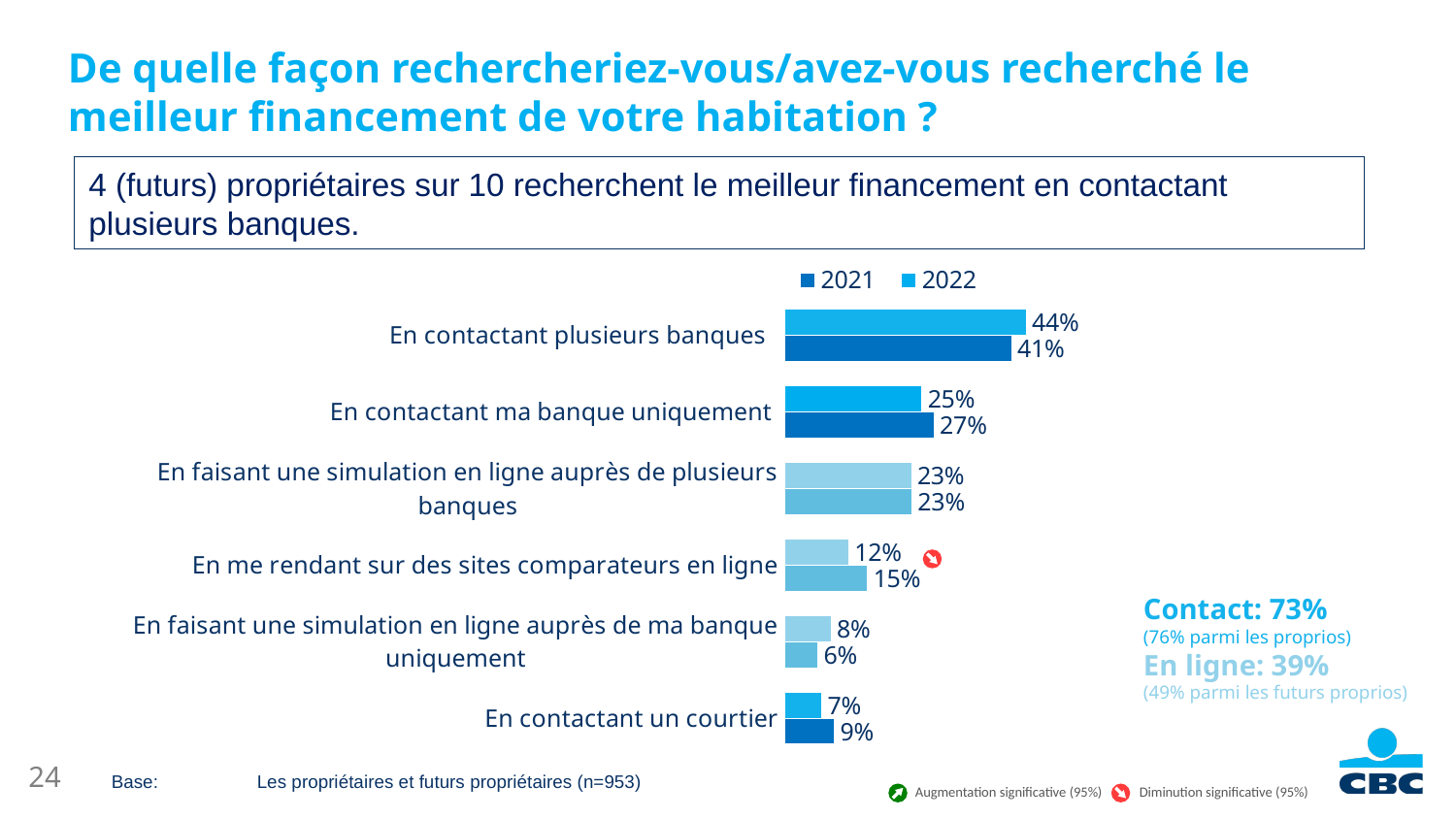
How many series does the chart legend list? 2 What is the 2021 value for 'En contactant ma banque uniquement'? 27% What is the difference between the 2022 and 2021 values for 'En contactant plusieurs banques'? 3% What is the 2021 value for 'En contactant plusieurs banques'? 41% Which category has the highest 2022 value? En contactant plusieurs banques What is the 2022 value for 'En me rendant sur des sites comparateurs en ligne'? 12% What kind of chart is shown on the slide? bar chart For 'En contactant ma banque uniquement', which year has the larger value, 2021 or 2022? 2021 What is the 2022 value for 'En contactant plusieurs banques'? 44% How many categories are shown in the chart? 6 Which category has the lowest 2021 value? En faisant une simulation en ligne auprès de ma banque uniquement What is the 2021 value for 'En contactant un courtier'? 9%